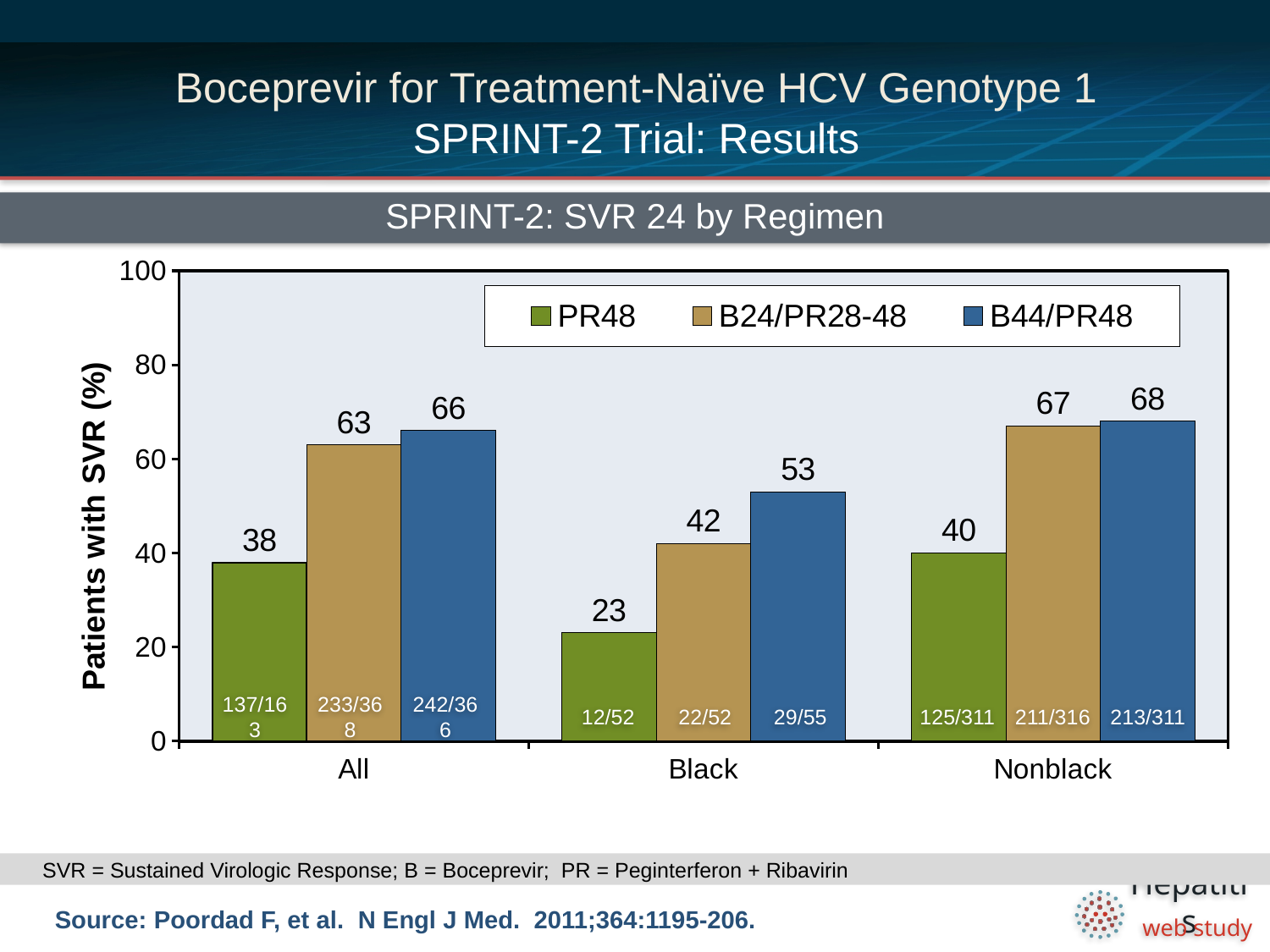
What is the SVR rate for the B24/PR28-48 regimen in the Nonblack group? 67 What is the title of the chart? SPRINT-2: SVR 24 by Regimen How many patient groups are shown on the x axis? 3 What is the SVR rate for the B44/PR48 regimen in the Black group? 53 What is the difference in SVR rate between B24/PR28-48 and PR48 in the Black group? 19 How many regimens does the legend list? 3 Which patient group has the highest SVR rate for the B44/PR48 regimen? Nonblack Which is larger: the PR48 SVR rate in the Nonblack group or the B24/PR28-48 SVR rate in the Black group? B24/PR28-48 in the Black group What is the SVR rate for the PR48 regimen in the All group? 38 What kind of chart is shown on the slide? Bar chart What is the difference in SVR rate between B44/PR48 and PR48 in the All group? 28 Which regimen has the lowest SVR rate in the Black group? PR48